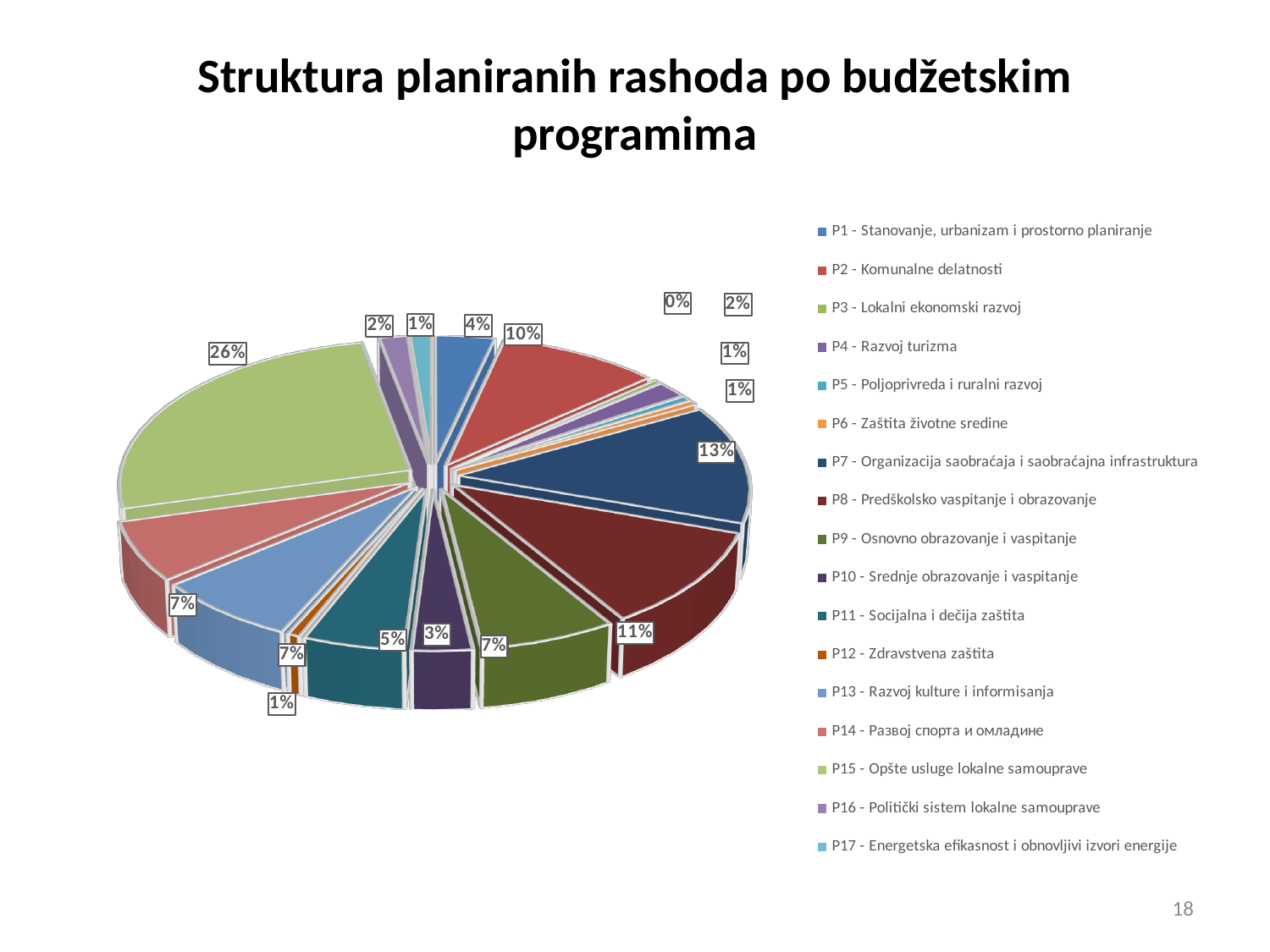
By how many percentage points does the share of P15 - Opšte usluge lokalne samouprave exceed that of P7 - Organizacija saobraćaja i saobraćajna infrastruktura? 13 percentage points What share of planned expenditures goes to P1 - Stanovanje, urbanizam i prostorno planiranje? 4% What share of planned expenditures goes to P7 - Organizacija saobraćaja i saobraćajna infrastruktura? 13% Which program has the largest share of planned expenditures? P15 - Opšte usluge lokalne samouprave What kind of chart is shown on the slide? pie chart How many programs (categories) does the legend list? 17 What share of planned expenditures goes to P15 - Opšte usluge lokalne samouprave? 26% Which has a larger share: P7 - Organizacija saobraćaja i saobraćajna infrastruktura or P8 - Predškolsko vaspitanje i obrazovanje? P7 - Organizacija saobraćaja i saobraćajna infrastruktura What is the title of the chart on the slide? Struktura planiranih rashoda po budžetskim programima